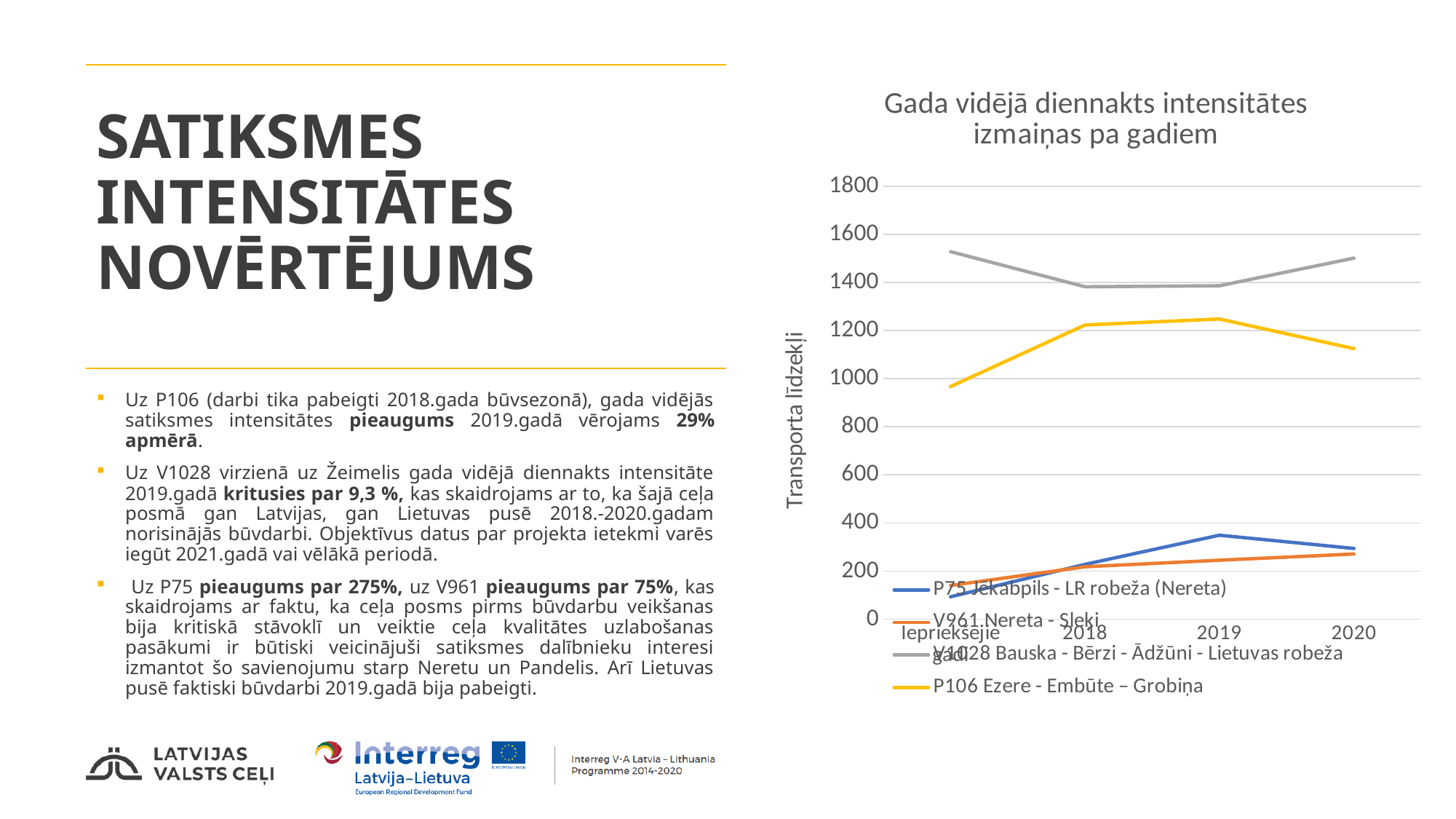
Is the value for V1028 Bauska - Bērzi - Ādžūni - Lietuvas robeža in Iepriekšējie gadi greater or less than 1400? greater What kind of chart is shown on the slide? line chart In 2018, which is larger: the value for P106 Ezere - Embūte – Grobiņa or the value for V1028 Bauska - Bērzi - Ādžūni - Lietuvas robeža? V1028 Bauska - Bērzi - Ādžūni - Lietuvas robeža How many series does the chart legend list? 4 What is the title of the chart? Gada vidējā diennakts intensitātes izmaiņas pa gadiem How many points are there along the x axis of the chart? 4 Which series has the highest value in 2020? V1028 Bauska - Bērzi - Ādžūni - Lietuvas robeža What is the label of the vertical axis of the chart? Transporta līdzekļi Does the value for P75 Jēkabpils - LR robeža (Nereta) rise or fall from 2019 to 2020? fall Is the value for P106 Ezere - Embūte – Grobiņa in 2020 greater or less than 1000? greater Which series has the lowest value in 2019? V961 Nereta - Sleķi Is the value for P75 Jēkabpils - LR robeža (Nereta) in 2019 greater or less than 400? less